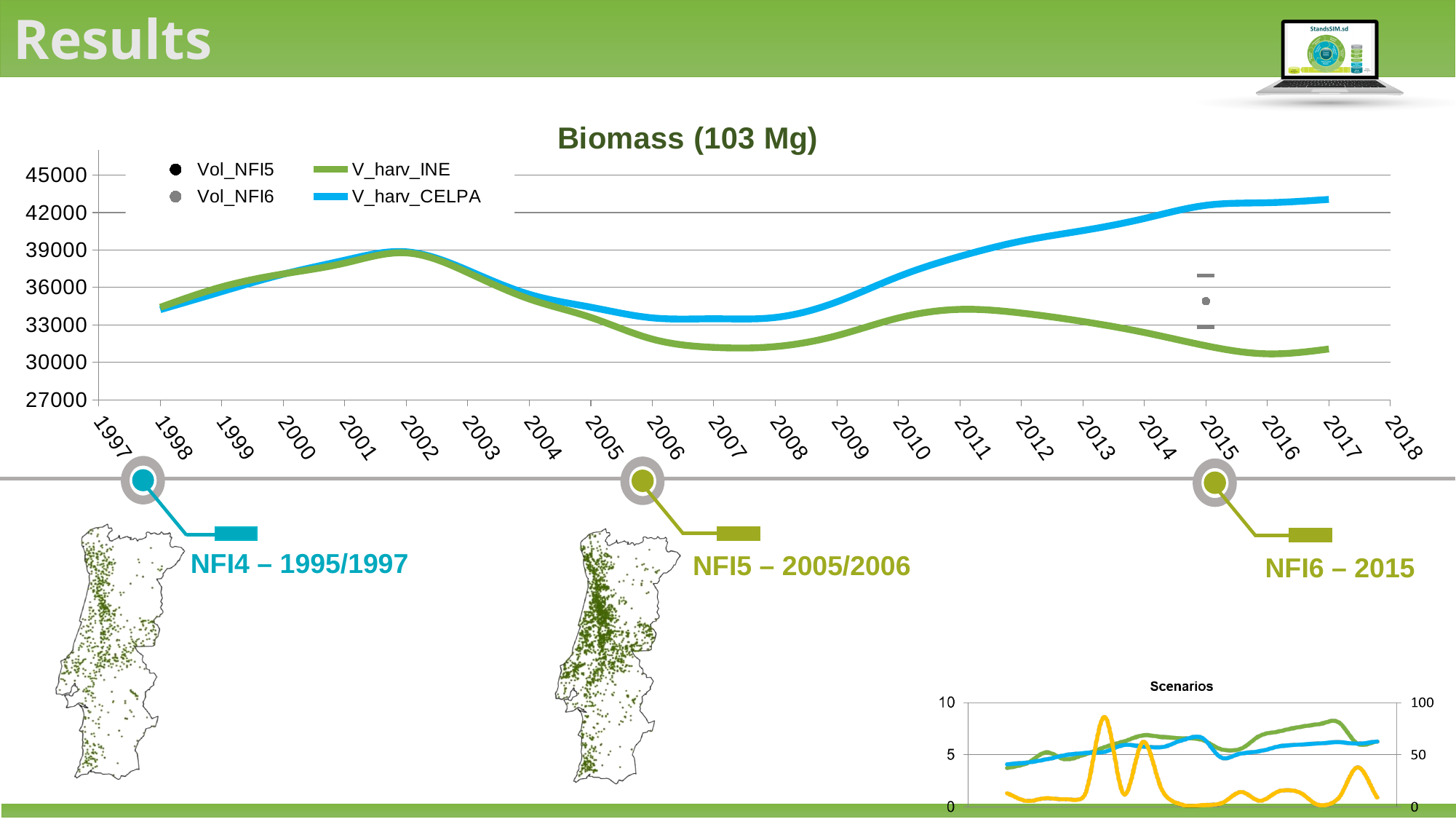
What kind of chart is the Biomass (103 Mg) chart? line chart In the Biomass (103 Mg) chart, is the value of V_harv_CELPA in 2017 greater or less than 42000? greater What is the title of the large chart on the slide? Biomass (103 Mg) How many entries does the legend of the Biomass (103 Mg) chart list? 4 What kind of chart is the small Scenarios chart at the bottom right of the slide? line chart In the Biomass (103 Mg) chart, does V_harv_CELPA rise or fall between 2011 and 2017? rise In the Biomass (103 Mg) chart, is the value of V_harv_CELPA in 2014 greater or less than 39000? greater In the Biomass (103 Mg) chart, is the value of V_harv_INE in 2017 greater or less than 33000? less In the Biomass (103 Mg) chart, what colour is the V_harv_CELPA line? blue In the Biomass (103 Mg) chart, does V_harv_INE rise or fall between 2011 and 2016? fall In the Biomass (103 Mg) chart, which series has the higher value in 2017, V_harv_INE or V_harv_CELPA? V_harv_CELPA